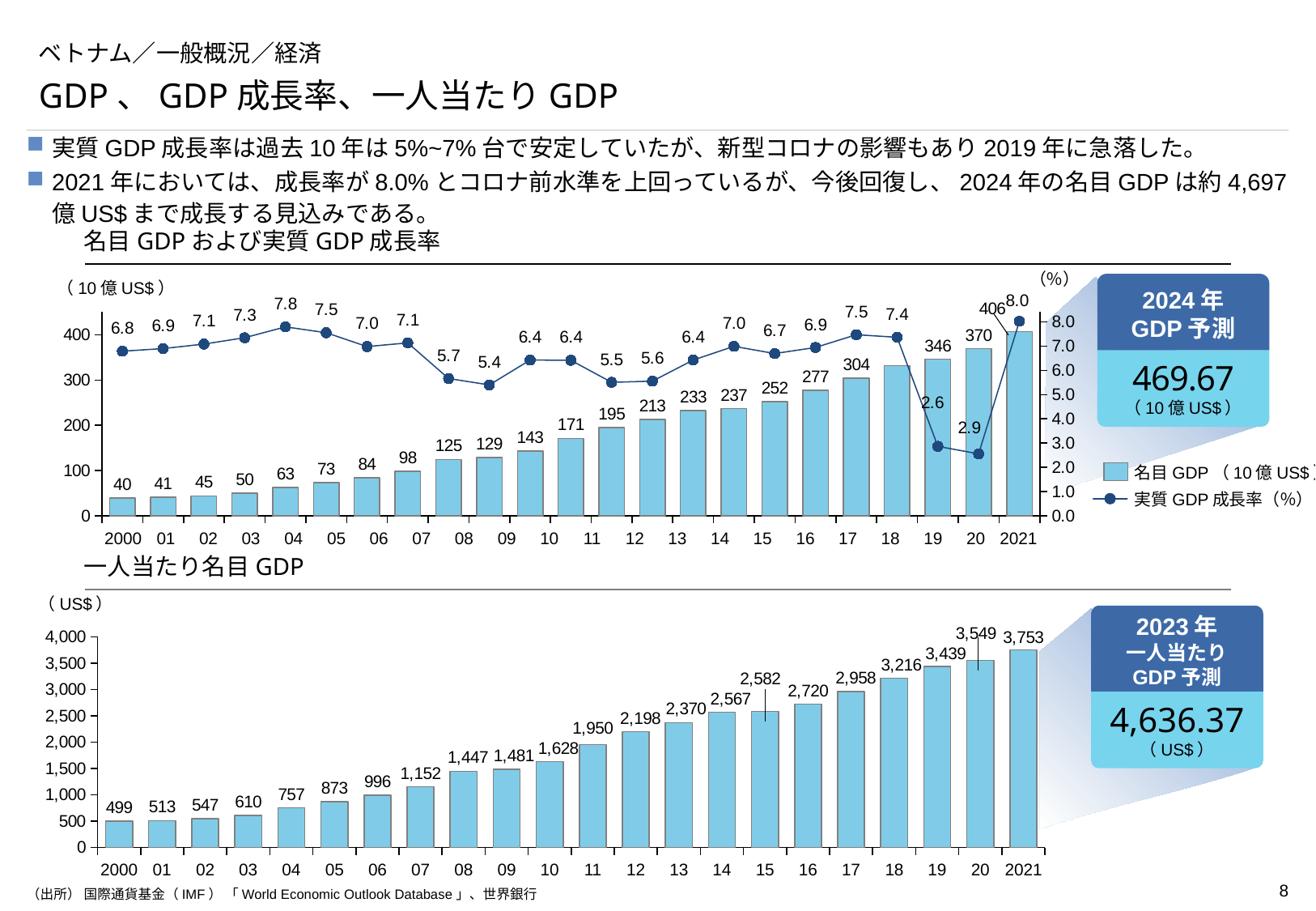
How many bars (years) are plotted in the 一人当たり名目GDP chart? 22 What kind of chart is the 一人当たり名目GDP chart at the bottom of the slide? bar chart In the 名目GDPおよび実質GDP成長率 chart, what is the highest 名目GDP bar value shown? 406 In the 一人当たり名目GDP chart, do the values generally rise or fall from 2000 to 2021? rise In the 一人当たり名目GDP chart, which year has the highest value? 2021 In the 一人当たり名目GDP chart, what is the value for 2000? 499 In the 一人当たり名目GDP chart, what is the value for 2010? 1,628 In the 一人当たり名目GDP chart, which is larger, the value for 2014 or the value for 2015? 2015 In the 一人当たり名目GDP chart, what is the difference between the 2021 value and the 2020 value? 204 In the 名目GDPおよび実質GDP成長率 chart, what is the lowest 実質GDP成長率 value shown on the line? 2.6 In the 一人当たり名目GDP chart, what is the value for 2021? 3,753 How many series does the legend of the 名目GDPおよび実質GDP成長率 chart list? 2